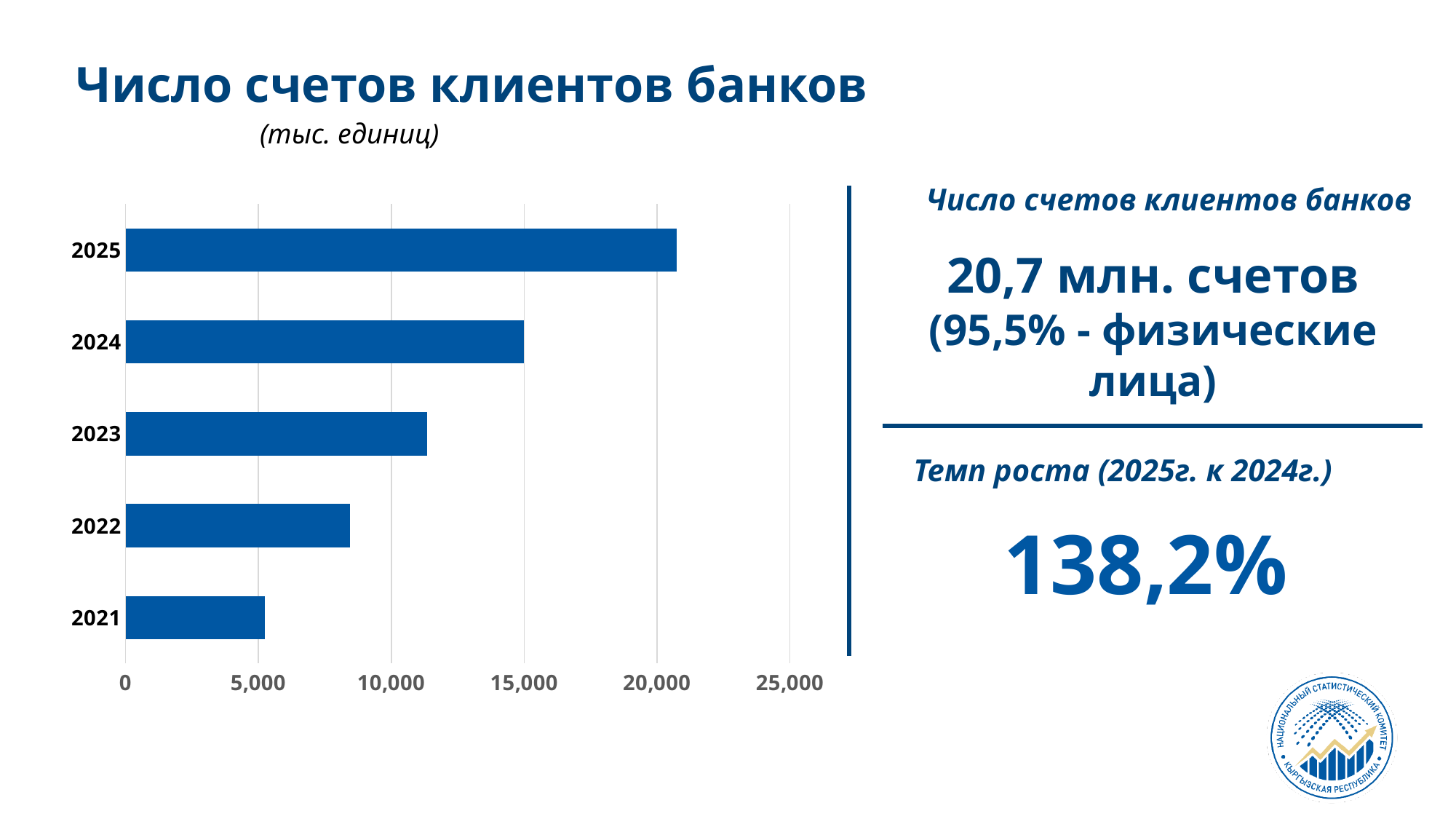
Is the value for 2022 greater or less than 10,000? less Is the value for 2023 greater or less than 10,000? greater In what units are the chart values given? тыс. единиц Which is larger, the value for 2024 or the value for 2023? 2024 Is the value for 2025 greater or less than 20,000? greater How many years are plotted in the chart? 5 Which year has the lowest number of bank client accounts in the chart? 2021 Which year has the highest number of bank client accounts in the chart? 2025 What kind of chart is shown on the slide? bar chart What is the title of the chart? Число счетов клиентов банков Do the values rise or fall from 2021 to 2025? rise